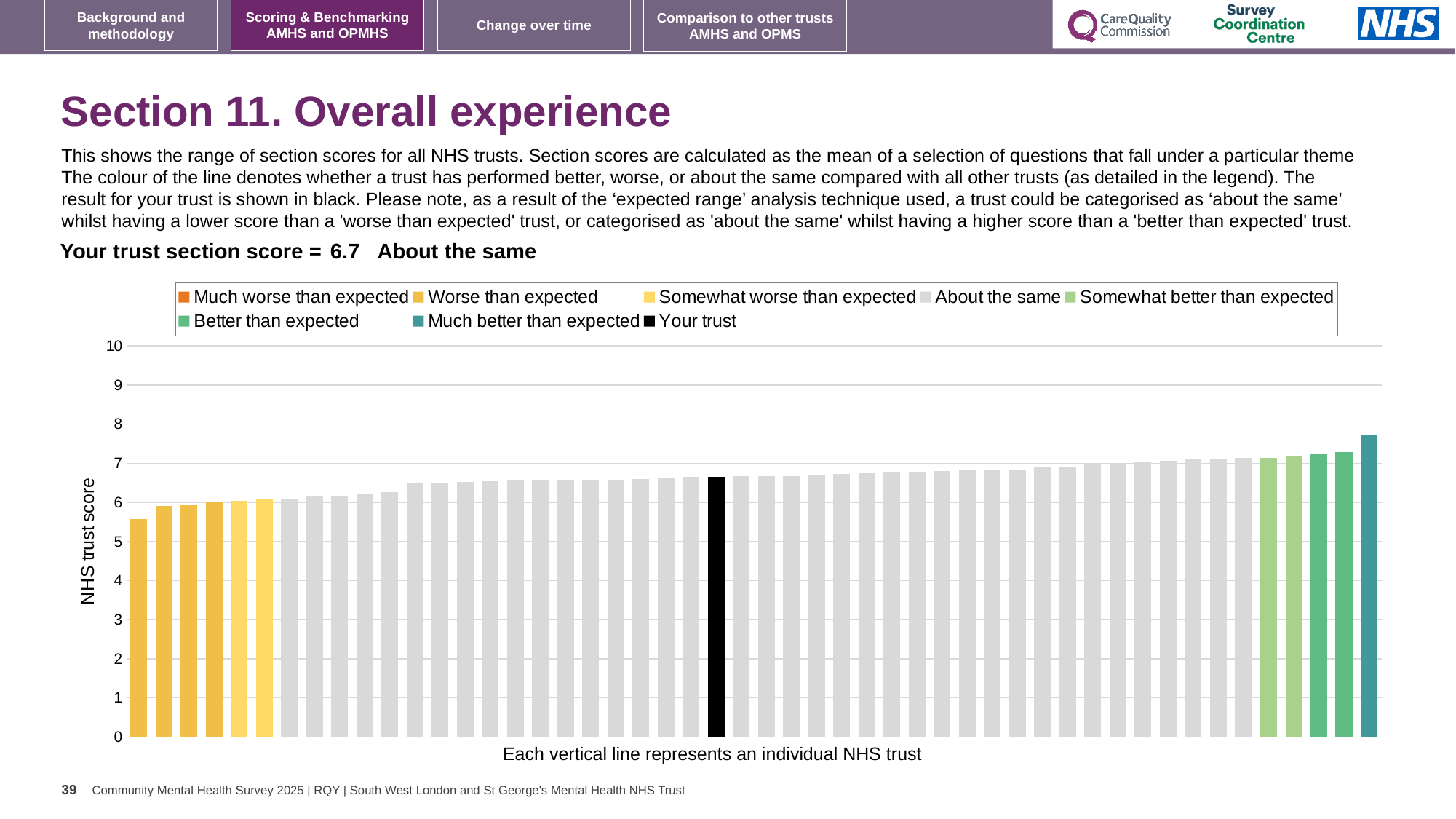
Is the value of the tallest bar greater or less than 7? greater Do the bar values rise or fall from left to right along the x axis? rise Is the value of the shortest bar greater or less than 6? less What is your trust's section score for Section 11, Overall experience? 6.7 What kind of chart is shown on the slide? bar chart How many bars are coloured as 'Much better than expected'? 1 Which category is your trust placed in for Section 11? About the same What colour is the bar representing your trust? black Is the value of the tallest bar greater or less than 8? less Which is larger: your trust's bar or the leftmost bar? your trust's bar How many entries does the chart legend list? 8 What is the title of the vertical axis? NHS trust score